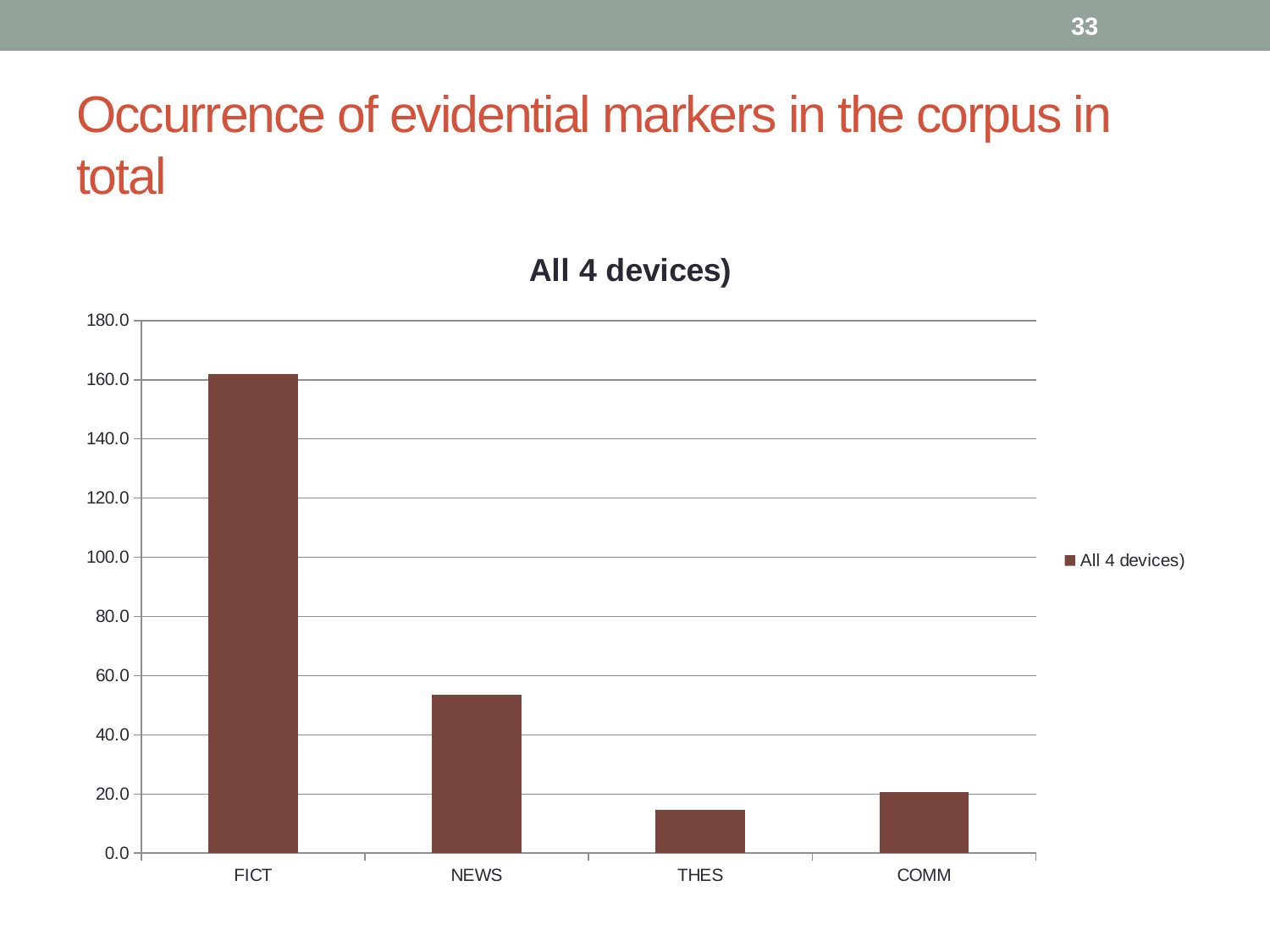
What kind of chart is shown on the slide? bar chart Is the value for COMM greater or less than 40? less Is the value for THES greater or less than 20? less Is the value for FICT greater or less than 140? greater How many series does the legend list? 1 Which category has the lowest value? THES What is the title of the chart? All 4 devices) Which is larger, the value for NEWS or the value for COMM? NEWS Which category has the highest value? FICT How many categories are shown on the x axis? 4